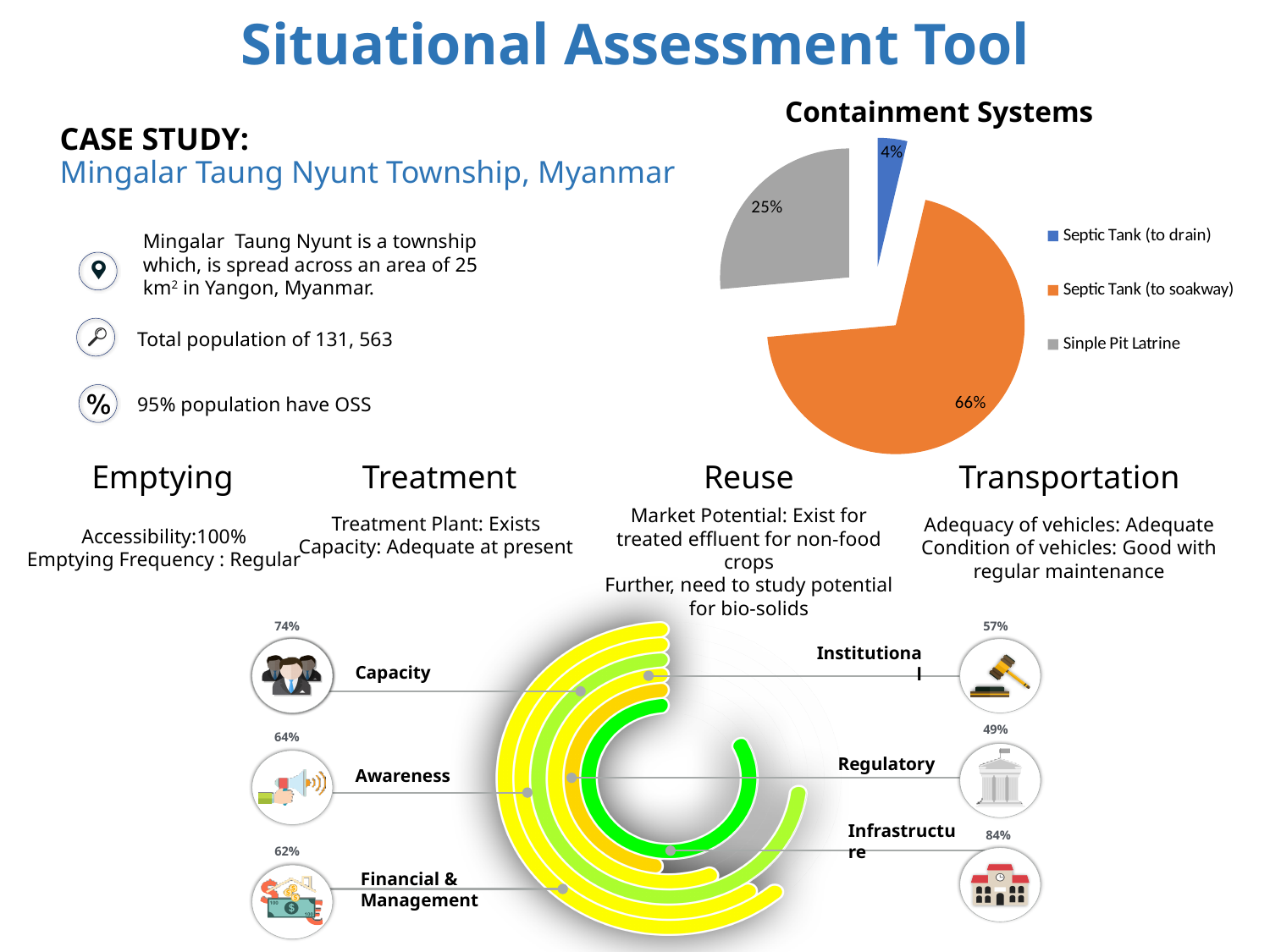
In the radial chart at the bottom of the slide, what percentage is shown for Infrastructure? 84% Which category has the smallest slice in the Containment Systems pie chart? Septic Tank (to drain) How many categories does the legend of the Containment Systems pie chart list? 3 In the Containment Systems pie chart, what is the difference in percentage points between Septic Tank (to soakway) and the pit latrine slice? 41 Which category has the largest slice in the Containment Systems pie chart? Septic Tank (to soakway) In the Containment Systems pie chart, what percentage is shown for Septic Tank (to soakway)? 66% What colour is the Septic Tank (to soakway) slice in the Containment Systems pie chart? Orange In the radial chart at the bottom of the slide, what percentage is shown for Regulatory? 49% In the Containment Systems pie chart, which is larger: Septic Tank (to drain) or the pit latrine slice? The pit latrine slice In the Containment Systems pie chart, what percentage is shown for the pit latrine slice? 25% What type of chart is the Containment Systems chart? Pie chart In the Containment Systems pie chart, what percentage is shown for Septic Tank (to drain)? 4%